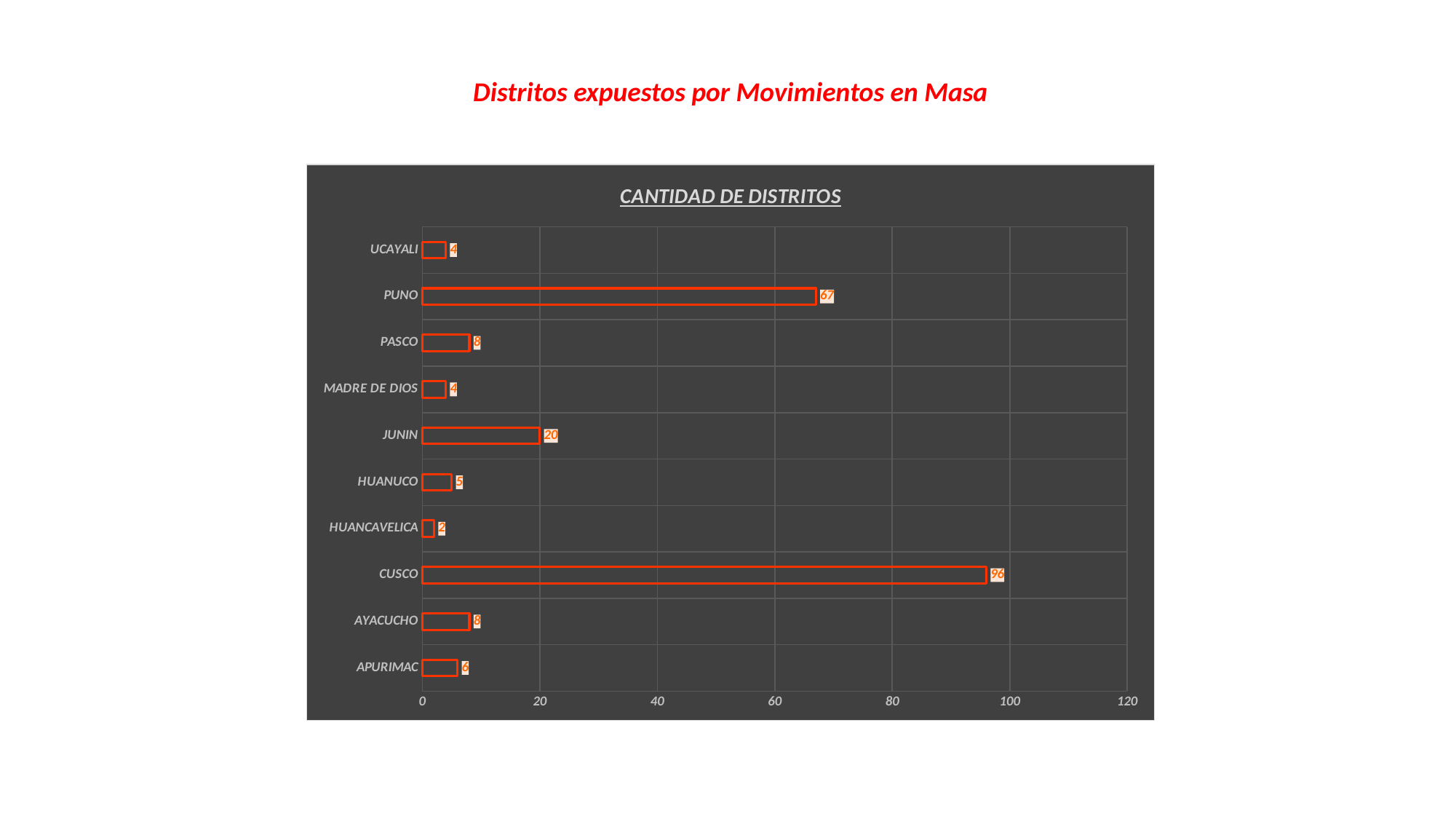
What is the value for CUSCO? 96 Which is larger, the value for JUNIN or the value for PASCO? JUNIN What is the value for PUNO? 67 Is the value for PUNO greater or less than 60? greater What kind of chart is shown on the slide? bar chart How many categories are shown in the chart? 10 Which category has the highest value? CUSCO What is the difference between the values for CUSCO and PUNO? 29 Which category has the lowest value? HUANCAVELICA What is the value for JUNIN? 20 What is the value for HUANCAVELICA? 2 What is the title of the chart? CANTIDAD DE DISTRITOS